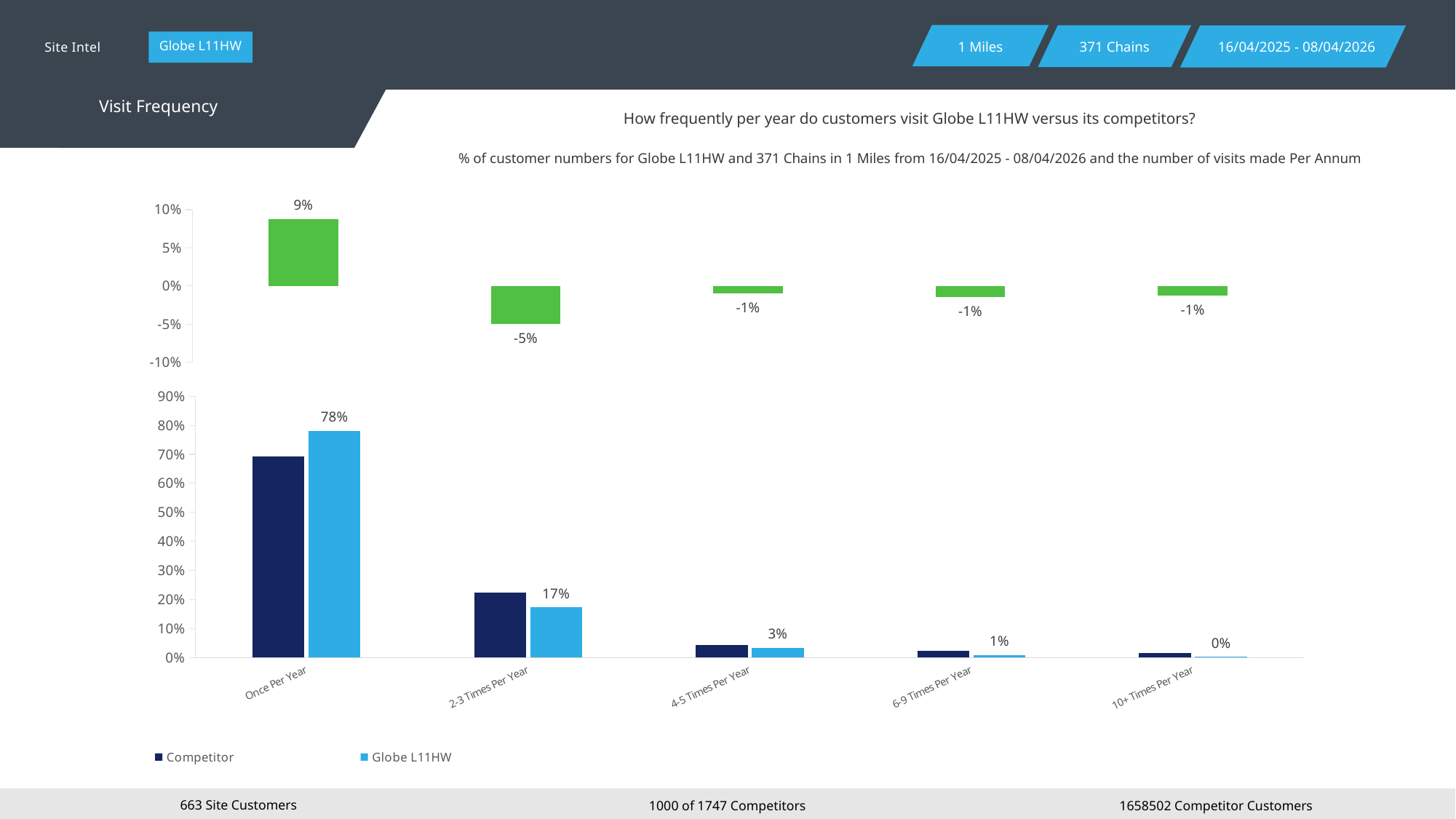
In the bottom chart, for Once Per Year, which is larger: Competitor or Globe L11HW? Globe L11HW In the bottom chart, is the Competitor value for Once Per Year greater or less than 60%? greater In the bottom chart, how many categories are shown on the x axis? 5 In the bottom chart, what is the value for Globe L11HW for Once Per Year? 78% In the bottom chart, what is the value for Globe L11HW for 2-3 Times Per Year? 17% In the bottom chart, which category has the highest Globe L11HW value? Once Per Year In the bottom chart, how many series does the legend list? 2 In the bottom chart, what is the difference between the Globe L11HW values for Once Per Year and 2-3 Times Per Year? 61% In the bottom chart, which category has the lowest Globe L11HW value? 10+ Times Per Year In the bottom chart, what is the value for Globe L11HW for 4-5 Times Per Year? 3% In the top chart, what is the value of the leftmost bar? 9% What kind of chart is the bottom chart? Bar chart